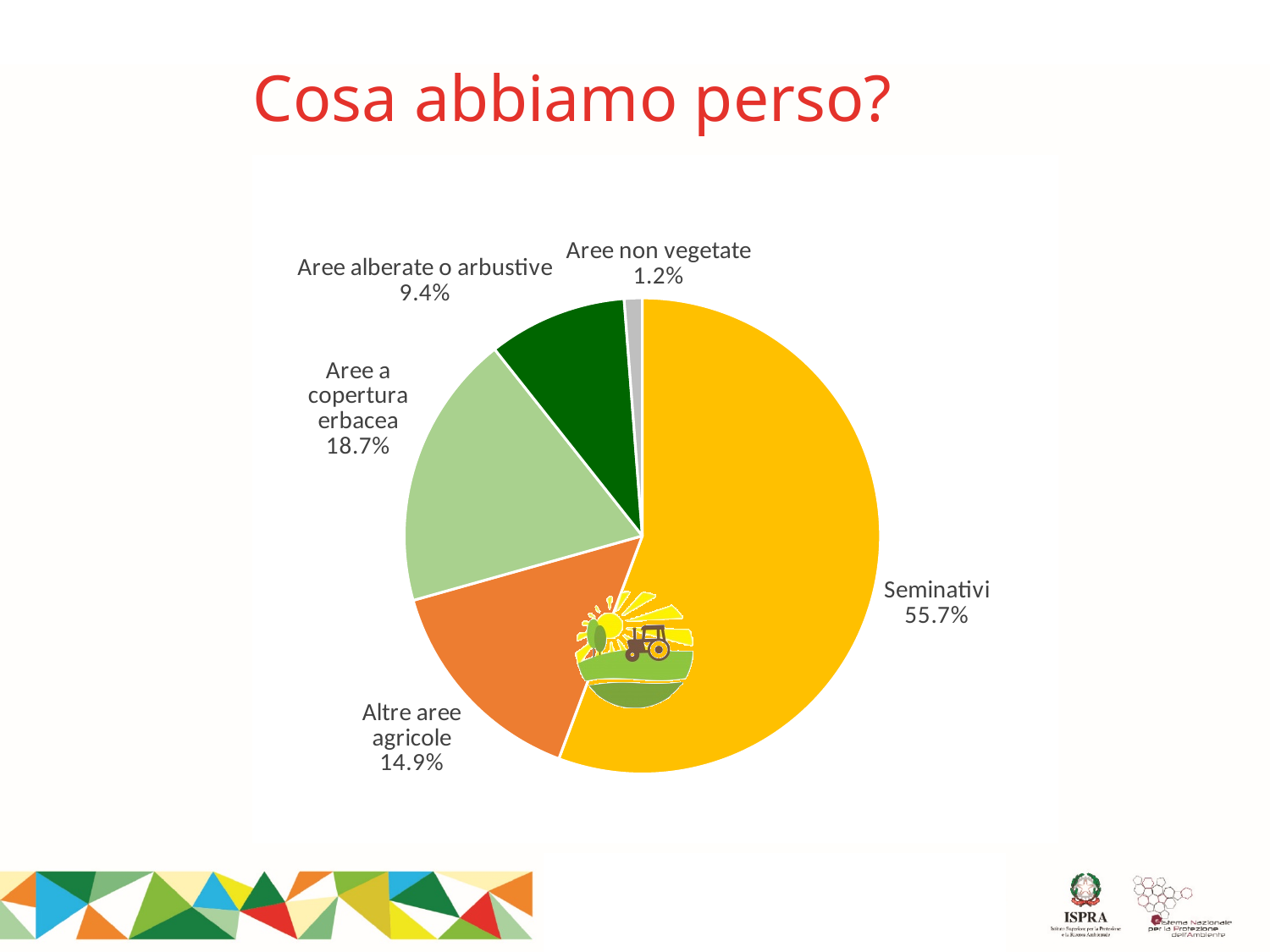
What is the difference in percentage points between Aree a copertura erbacea and Altre aree agricole? 3.8 What is the value shown for Altre aree agricole? 14.9% Which category has the largest slice of the pie? Seminativi What kind of chart is shown on the slide? pie chart What share of the pie does Seminativi represent? 55.7% How many categories are shown in the pie chart? 5 Which is larger, Aree alberate o arbustive or Altre aree agricole? Altre aree agricole Which category has the smallest slice of the pie? Aree non vegetate What is the value shown for Aree non vegetate? 1.2% What is the value shown for Aree alberate o arbustive? 9.4% What is the value shown for Aree a copertura erbacea? 18.7% What is the title of the slide containing the chart? Cosa abbiamo perso?